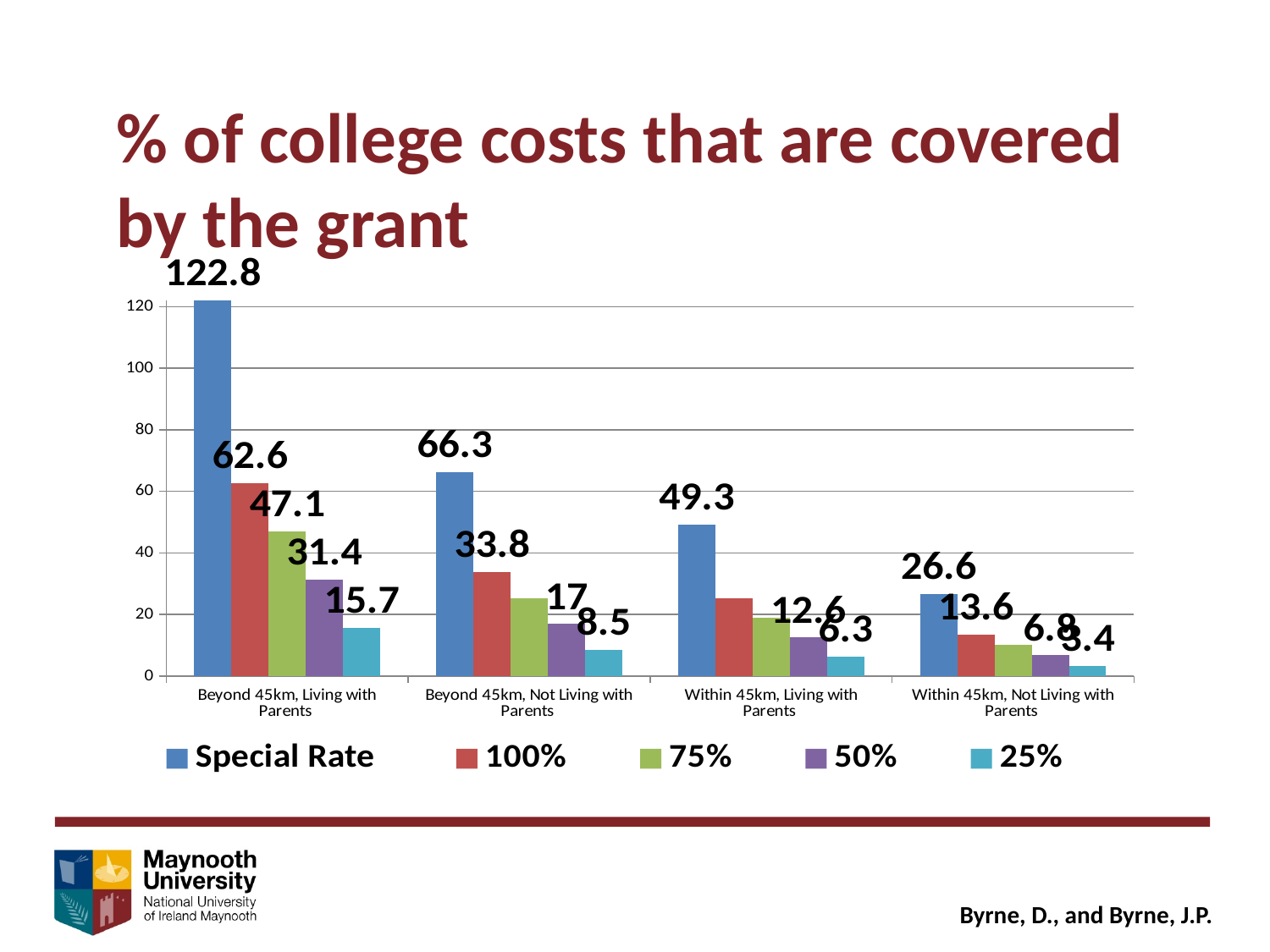
Is the value for the 75% grant in the Beyond 45km, Not Living with Parents category greater or less than 20? greater What is the value for the 100% grant in the Beyond 45km, Not Living with Parents category? 33.8 Which category has the lowest value for the 25% grant? Within 45km, Not Living with Parents How many series does the legend list? 5 Do the Special Rate values rise or fall moving from left to right across the categories? fall What is the difference between the Special Rate and 100% values in the Beyond 45km, Living with Parents category? 60.2 What is the value for the Special Rate grant in the Within 45km, Not Living with Parents category? 26.6 How many categories are shown on the x axis? 4 Which is larger: the Special Rate value for Within 45km, Living with Parents or the Special Rate value for Beyond 45km, Not Living with Parents? Beyond 45km, Not Living with Parents Which category has the highest Special Rate value? Beyond 45km, Living with Parents What is the value for the 25% grant in the Beyond 45km, Living with Parents category? 15.7 What percentage of college costs does the Special Rate grant cover for students Beyond 45km, Living with Parents? 122.8